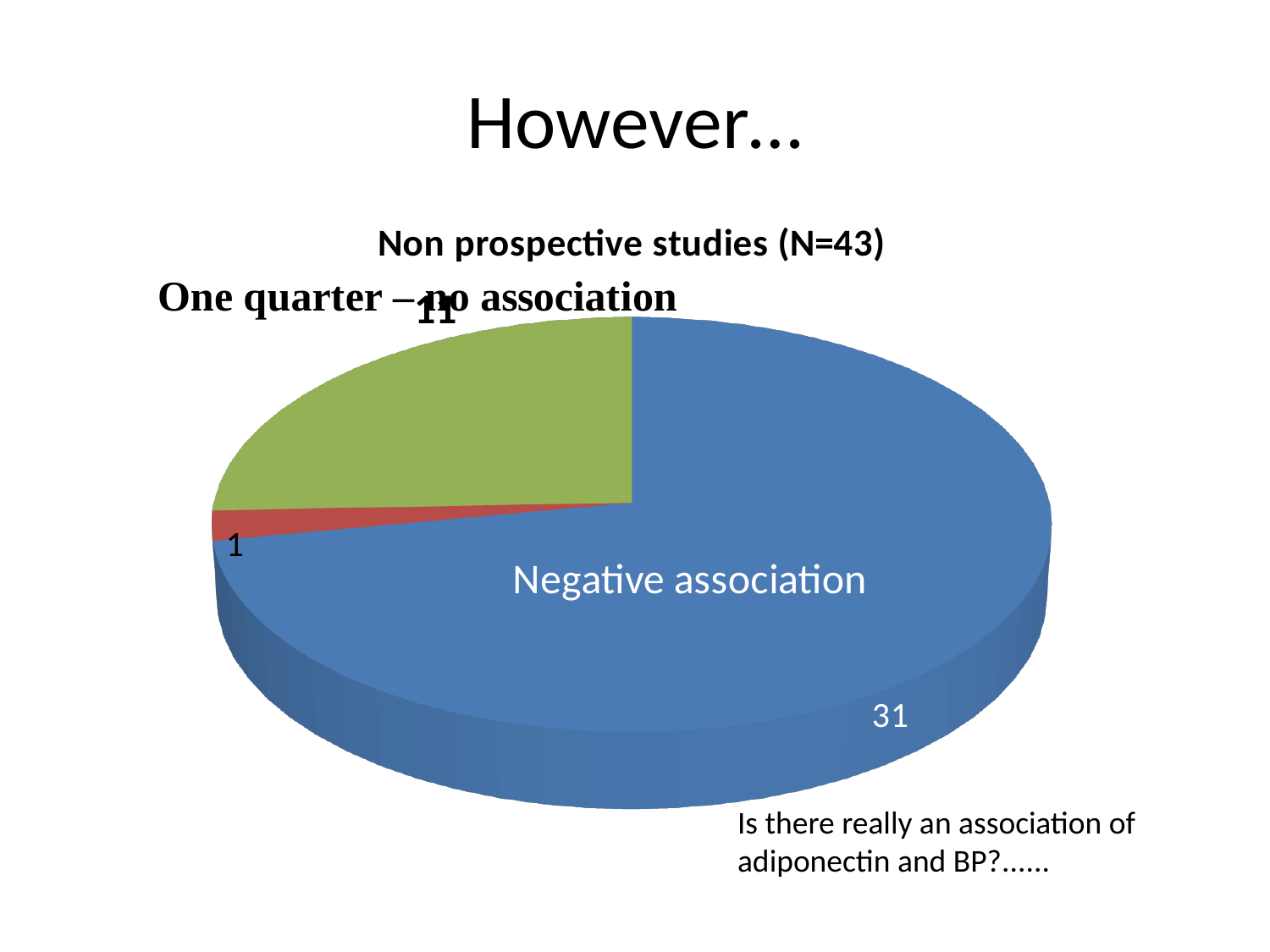
Which slice of the pie is the smallest? the red slice (1) Which is larger, the Negative association slice or the green slice? Negative association How many slices does the pie chart have? 3 What value is shown for the green slice of the pie? 11 What value is shown for the red slice of the pie? 1 What is the total number of studies represented in the pie chart? 43 What is the title of the chart? Non prospective studies (N=43) What type of chart is shown on the slide? pie chart What colour is the Negative association slice? blue Which slice of the pie is the largest? Negative association What is the difference between the Negative association slice and the green slice? 20 How many studies are in the Negative association slice? 31